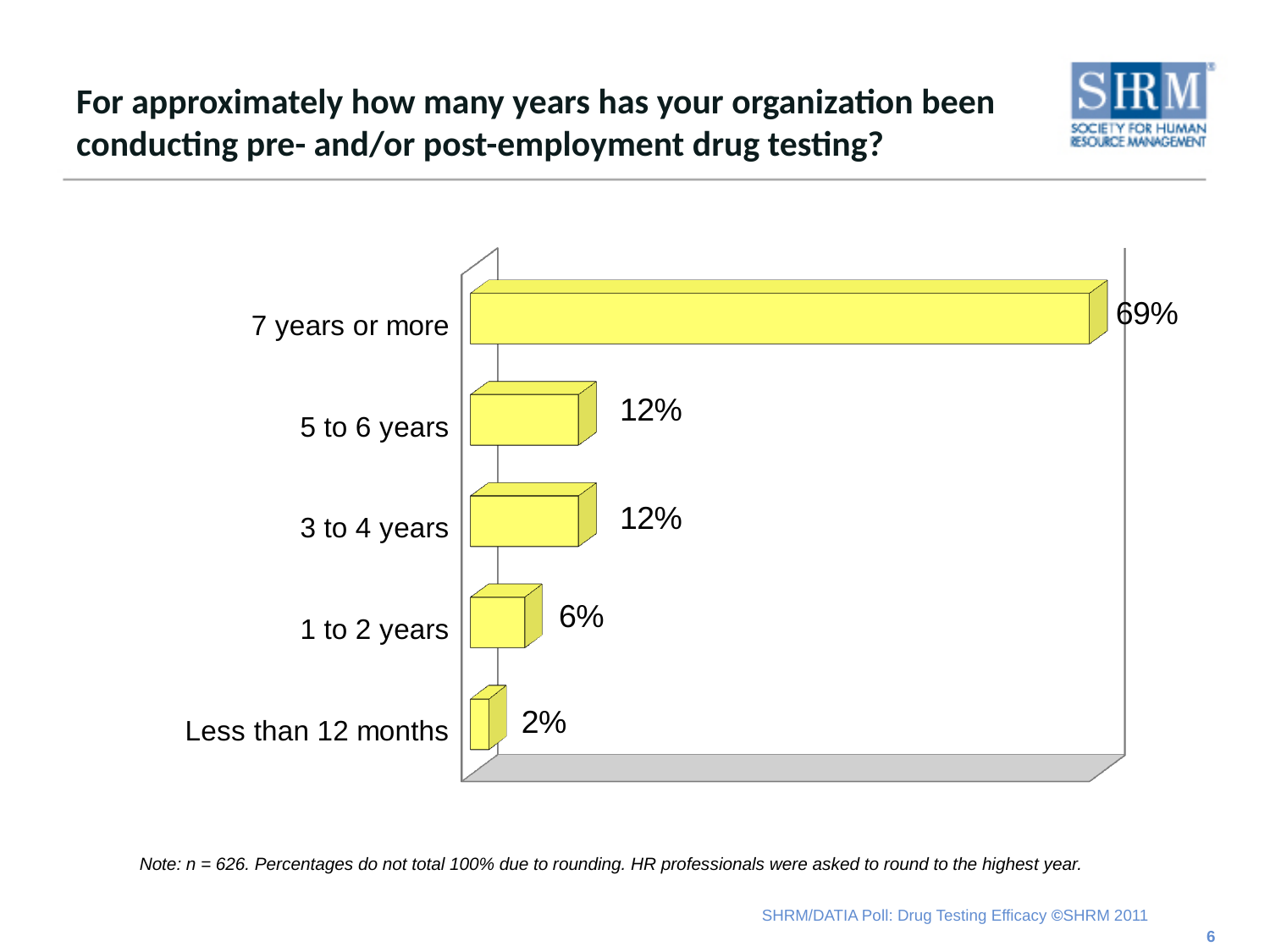
What is the difference between the values for '7 years or more' and '5 to 6 years'? 57% What percentage of organizations have been conducting drug testing for 7 years or more? 69% Which is larger, the value for '3 to 4 years' or the value for '1 to 2 years'? 3 to 4 years Which category has the highest value? 7 years or more How many categories are shown in the chart? 5 What is the value for the '1 to 2 years' category? 6% What colour are the bars in the chart? Yellow What is the difference between the values for '1 to 2 years' and 'Less than 12 months'? 4% What kind of chart is shown on the slide? Bar chart What is the value for the 'Less than 12 months' category? 2% Which category has the lowest value? Less than 12 months What is the value for the '5 to 6 years' category? 12%